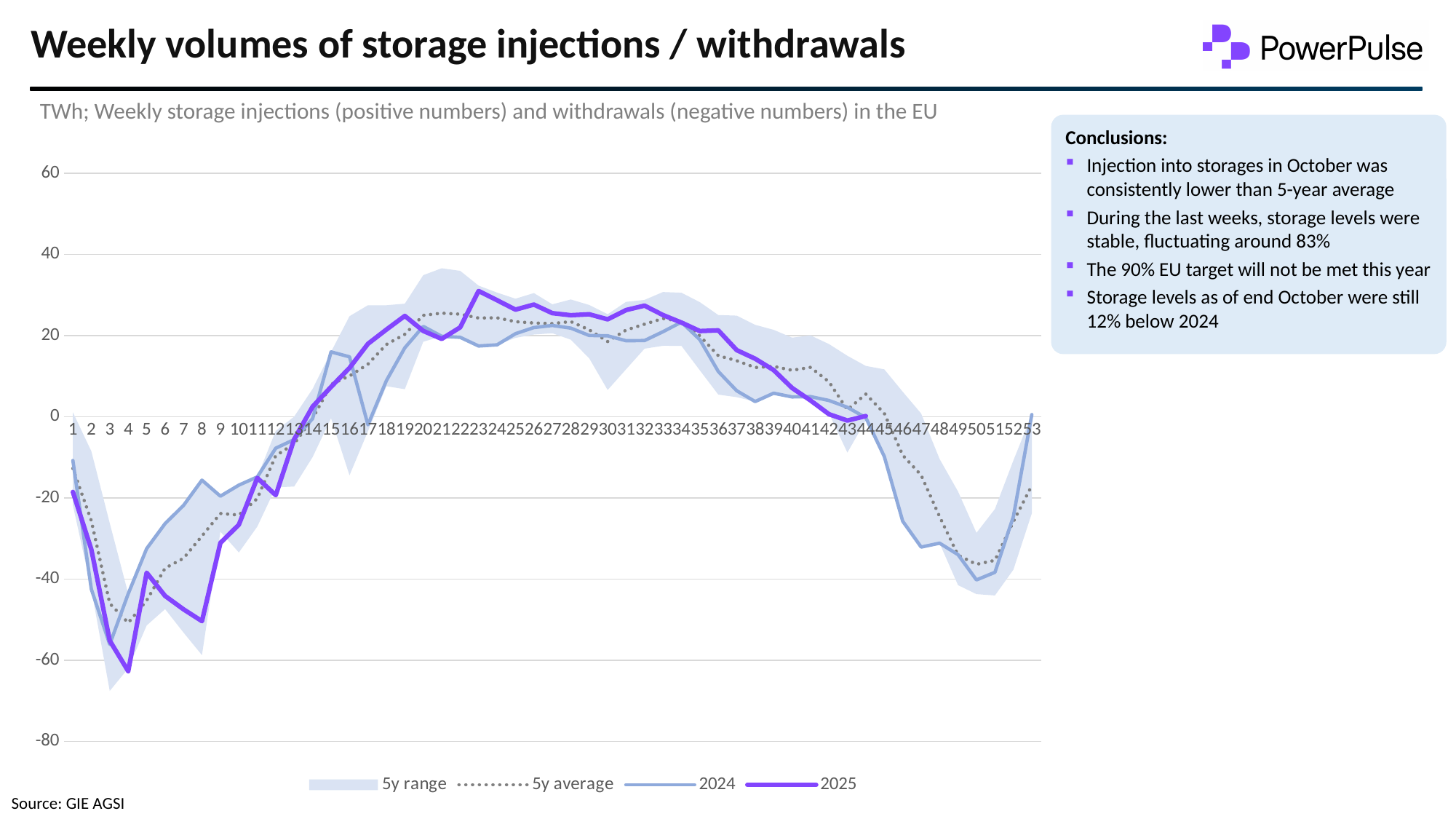
At week 23, which series has the larger value, 2024 or 2025? 2025 What kind of chart is shown on the slide? line chart Do the 2025 values rise or fall from week 23 to week 43? fall Is the 2025 value for week 23 greater or less than 20? greater How many weeks are labelled along the x axis? 53 In which week does the 2025 line reach its lowest value? 4 At week 8, which series has the larger value, 2024 or 2025? 2024 What is the source cited for the chart? GIE AGSI Is the 2024 value for week 3 greater or less than -40? less Is the 2025 value for week 1 greater or less than -40? greater How many series does the legend list? 4